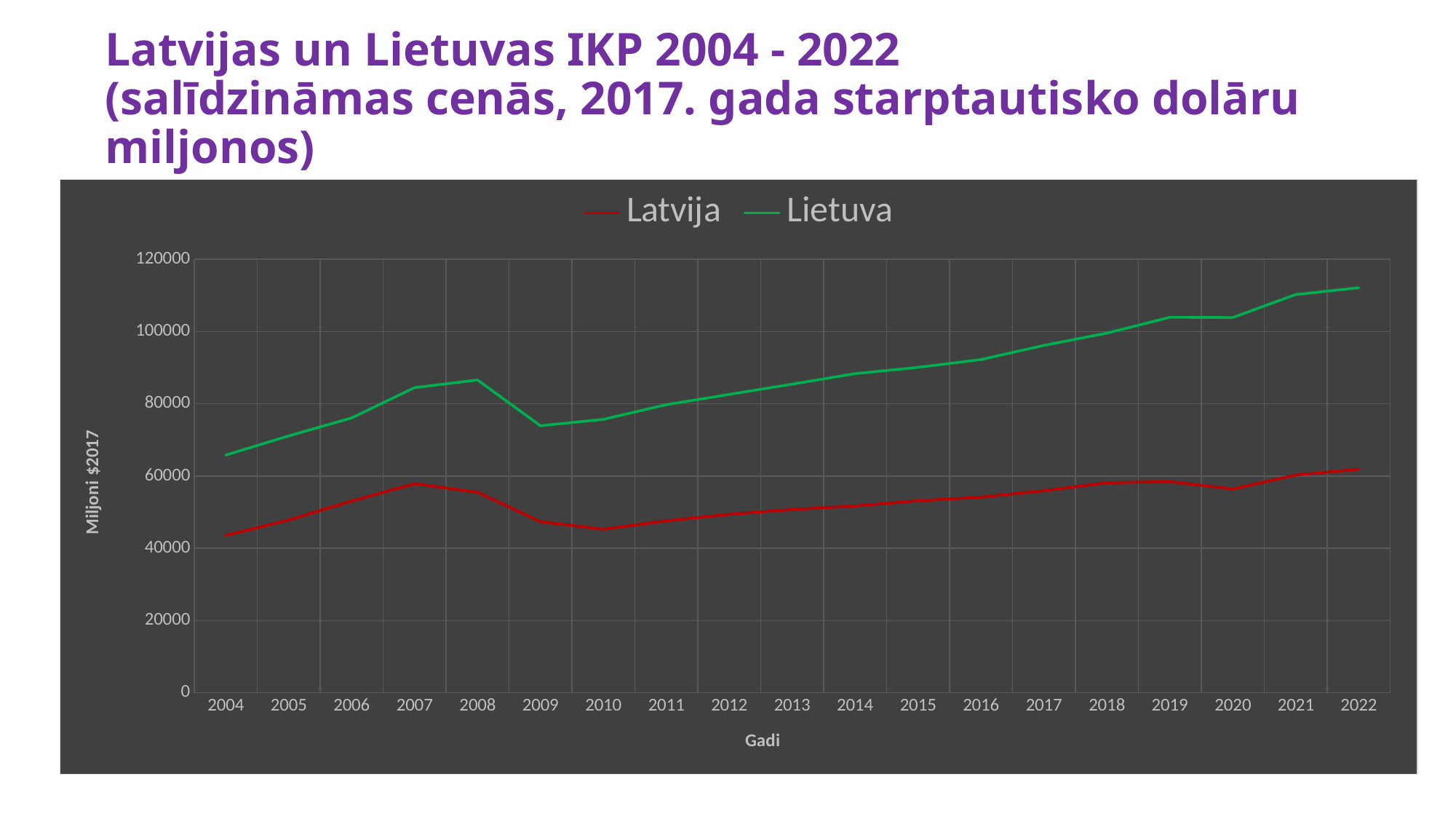
How many series does the legend list? 2 What kind of chart is shown on the slide? line chart In which year is the value for Lietuva lowest? 2004 In which year is the value for Lietuva highest? 2022 Is the value for Latvija in 2004 greater or less than 60000? less Is the value for Lietuva in 2004 greater or less than 60000? greater Is the value for Lietuva in 2009 greater or less than 80000? less Which series has the larger value in 2015, Latvija or Lietuva? Lietuva Do the values for Lietuva rise or fall from 2010 to 2022? rise What is the label of the y axis? Miljoni $2017 How many years are plotted along the x axis? 19